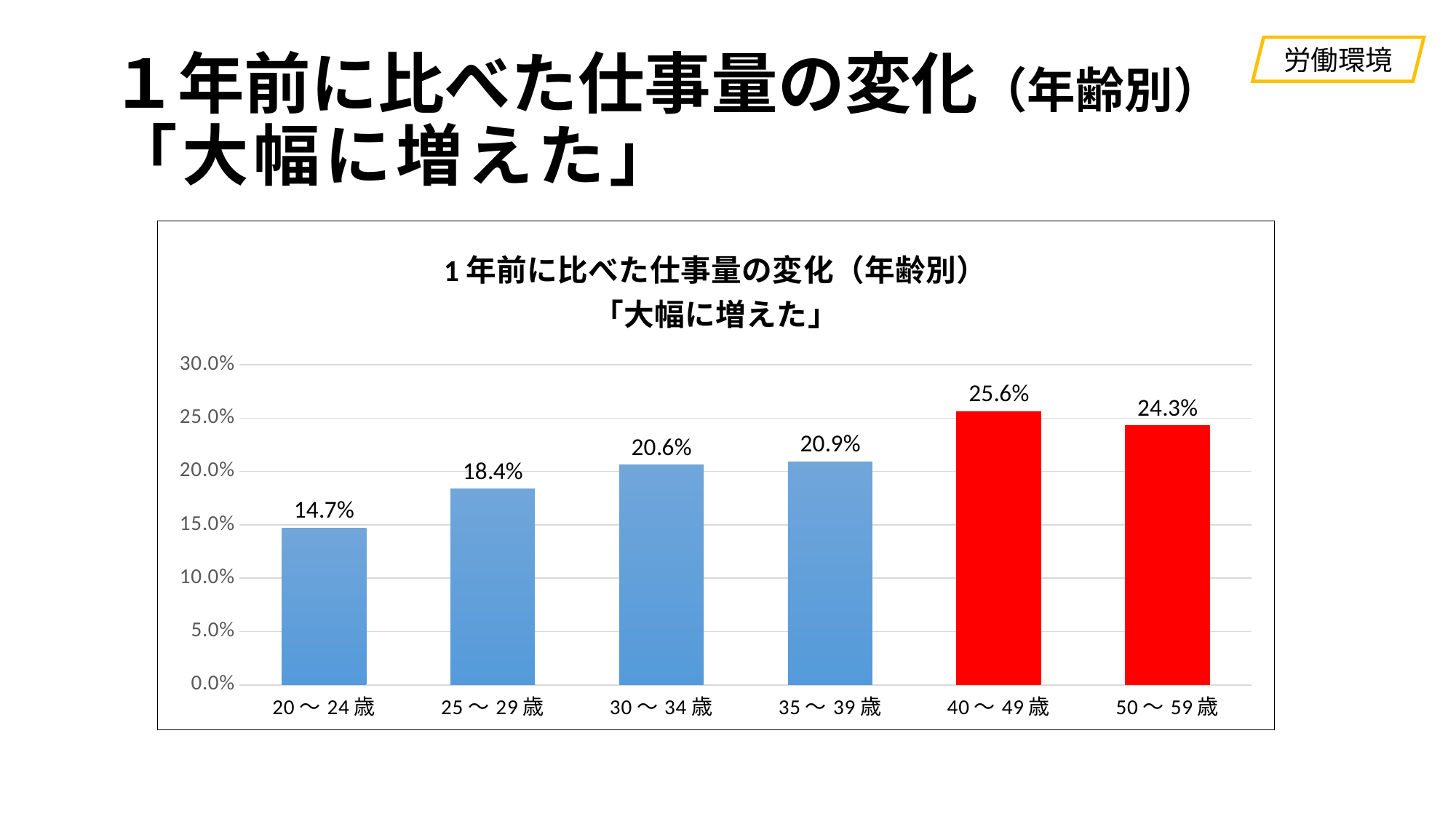
Which bars are coloured red? 40～49歳 and 50～59歳 Which age group has the lowest value? 20～24歳 What is the value for 40～49歳? 25.6% Is the value for 30～34歳 greater or less than 20.0%? greater What is the difference between the values for 25～29歳 and 20～24歳? 3.7% Which is larger, the value for 40～49歳 or the value for 50～59歳? 40～49歳 How many age groups are shown in the chart? 6 What is the value for 50～59歳? 24.3% What kind of chart is shown on the slide? bar chart What is the value for 20～24歳? 14.7% What is the difference between the values for 40～49歳 and 20～24歳? 10.9% Which age group has the highest value? 40～49歳